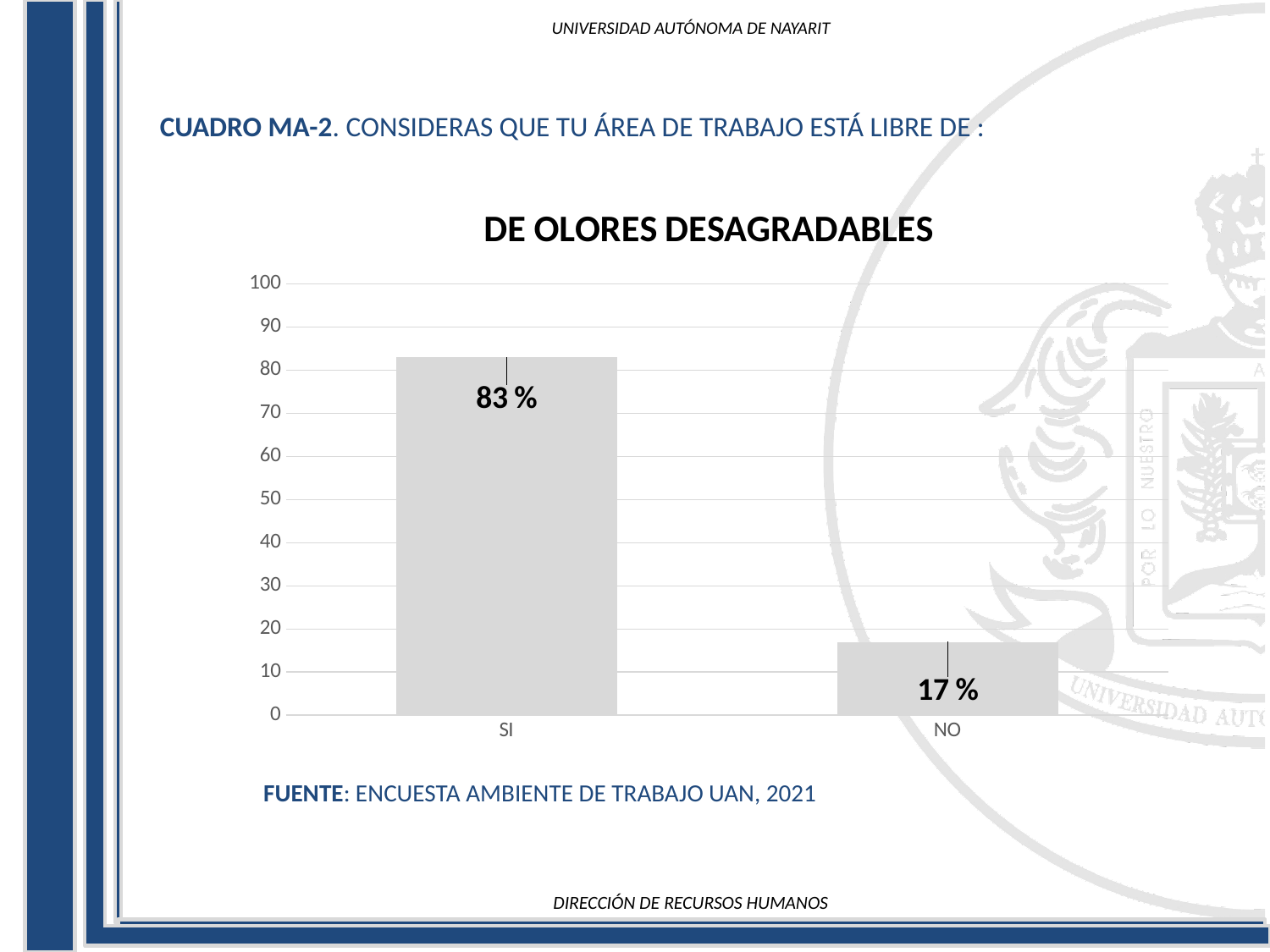
What is the difference between the values for SI and NO? 66 % What is the value for SI? 83 % What is the value for NO? 17 % What is the title of the chart? DE OLORES DESAGRADABLES Which category has the lowest value? NO What is the maximum value shown on the y axis? 100 Is the value for SI greater or less than 80? greater Which category has the highest value? SI Is the value for NO greater or less than 20? less Which is larger, the value for SI or the value for NO? SI What kind of chart is shown? bar chart How many categories are shown on the x axis? 2